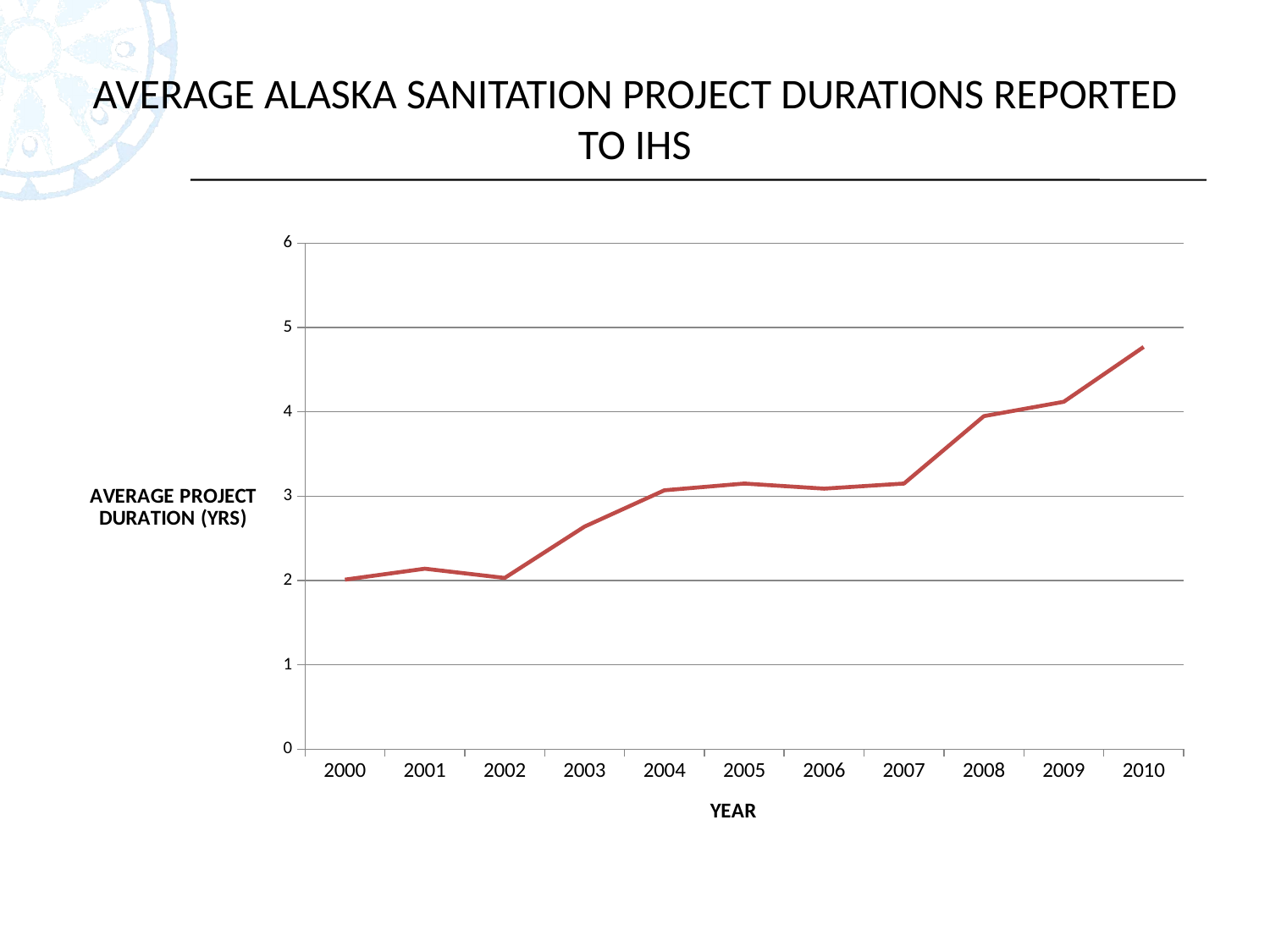
Is the value for 2008 greater or less than 5? less Is the value for 2005 greater or less than 3? greater Which year has the highest average project duration? 2010 Is the value for 2003 greater or less than 3? less What is the label of the y axis? AVERAGE PROJECT DURATION (YRS) What kind of chart is shown on the slide? line chart What is the label of the x axis? YEAR Which is larger, the value for 2008 or the value for 2004? 2008 How many years are plotted on the x axis? 11 Do the values generally rise or fall from 2000 to 2010? rise